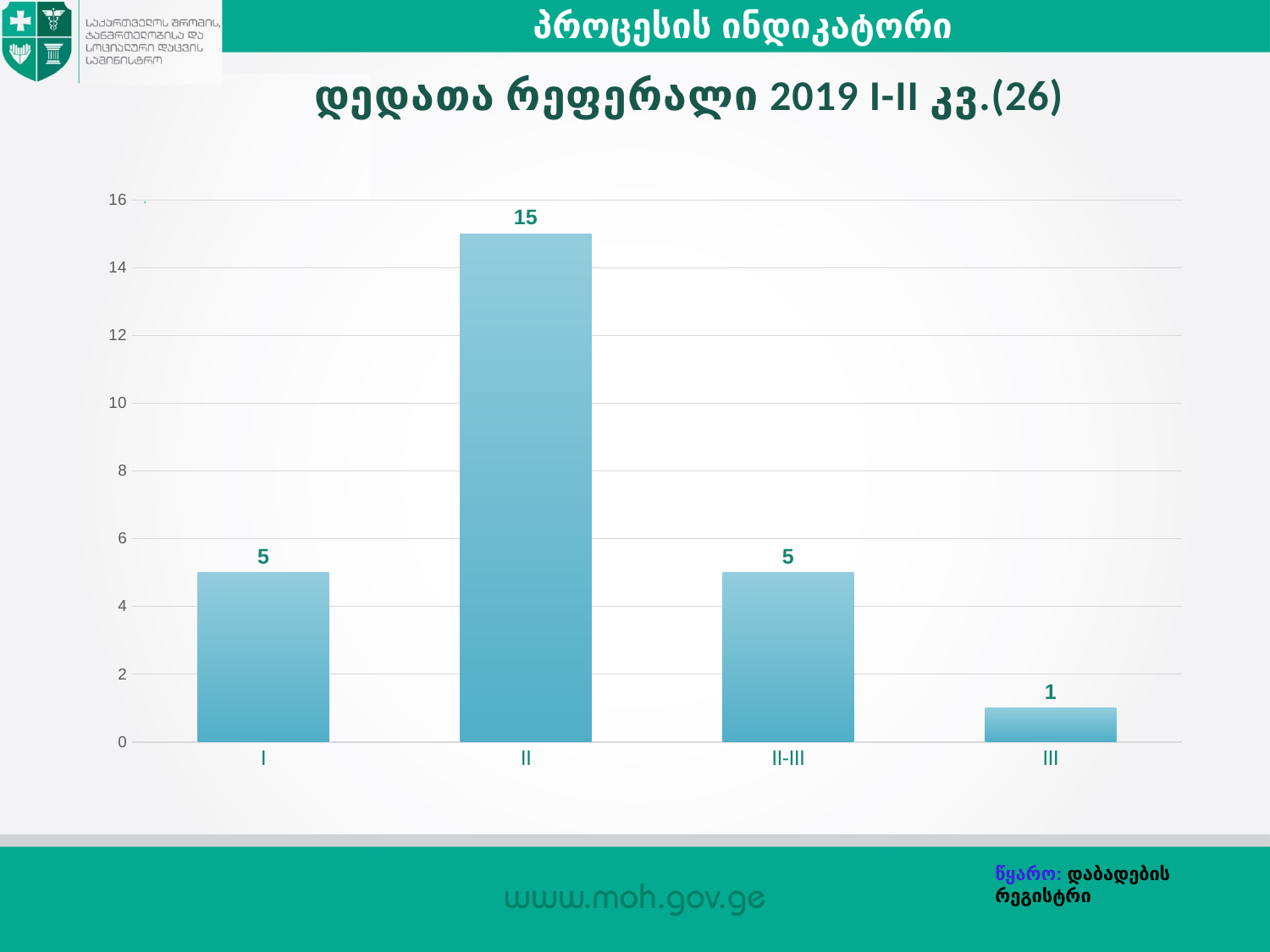
What is the difference between the values for II and III? 14 What is the value for category II-III? 5 What is the value for category II? 15 What is the total of the values for I and II-III? 10 Which category has the lowest value? III Which is larger, the value for I or the value for III? I How many categories are shown on the x axis? 4 Is the value for II greater or less than 10? greater Which category has the highest value? II What is the difference between the values for II and I? 10 What kind of chart is shown on the slide? bar chart What is the value for category III? 1